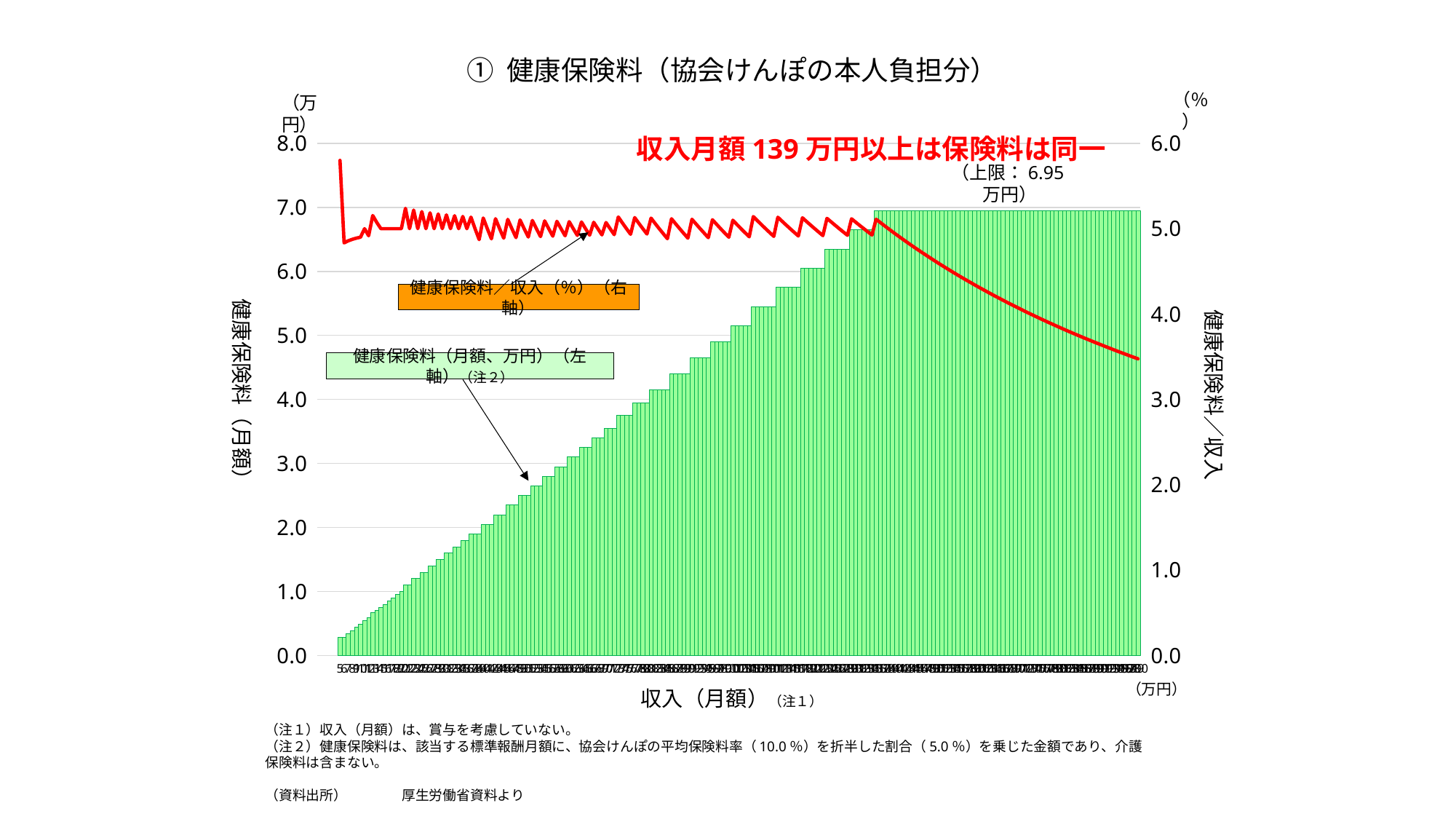
According to the annotation, from what monthly income level does the health insurance premium stay the same? 139万円以上 Do the green bars (健康保険料, 月額) rise or fall as monthly income increases along the x axis before reaching the cap? rise Does the red line (健康保険料／収入) rise or fall along the x axis after the premium reaches its cap? fall How many data series are plotted on the chart? 2 According to the annotation, what is the upper limit (上限) of the monthly health insurance premium? 6.95万円 Which series is plotted against the right axis? 健康保険料／収入（%） What is the maximum value shown on the left vertical axis? 8.0 Is the value of the red line (健康保険料／収入) at the far left of the chart greater or less than 5.0%? greater Is the height of the tallest green bar (健康保険料, 月額) greater or less than 6.0万円? greater What kind of chart is this? Combination of a bar chart and a line chart What is the title of the chart? ① 健康保険料（協会けんぽの本人負担分） Is the value of the red line (健康保険料／収入) at the far right of the chart greater or less than 4.0%? less